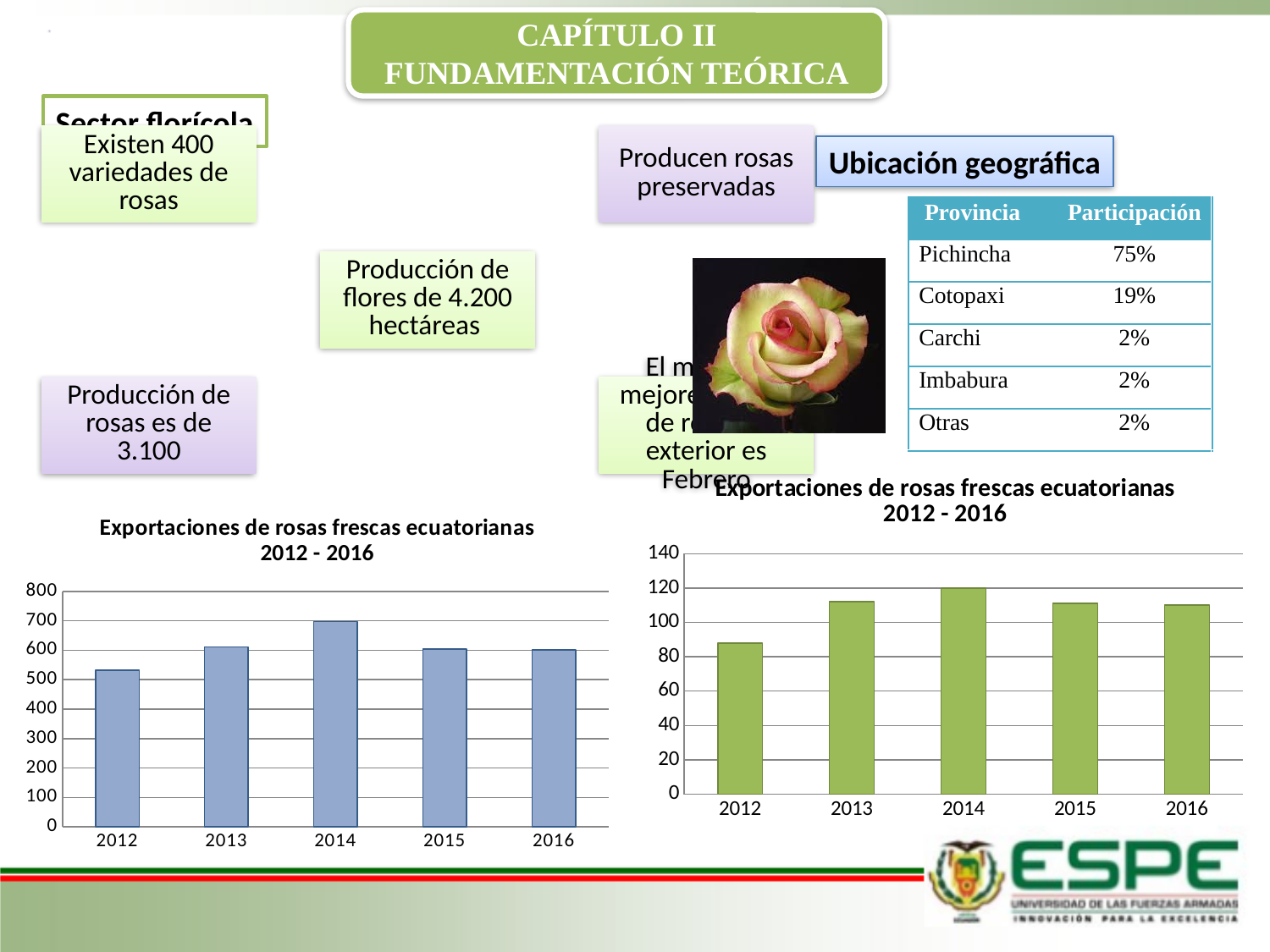
What kind of chart is the right chart (green bars)? bar chart On the left chart (blue bars), is the value for 2012 greater or less than 500? greater On the left chart (blue bars), which year has the lowest value? 2012 On the right chart (green bars), which year has the lowest value? 2012 On the right chart (green bars), which year has the highest value? 2014 On the left chart (blue bars), which year has the highest value? 2014 On the right chart (green bars), is the value for 2012 greater or less than 100? less On the left chart (blue bars), is the value for 2014 greater or less than 600? greater On the right chart (green bars), do the values rise or fall from 2012 to 2014? rise On the left chart (blue bars), how many years are shown on the x axis? 5 On the left chart (blue bars), which is larger, the value for 2014 or the value for 2012? 2014